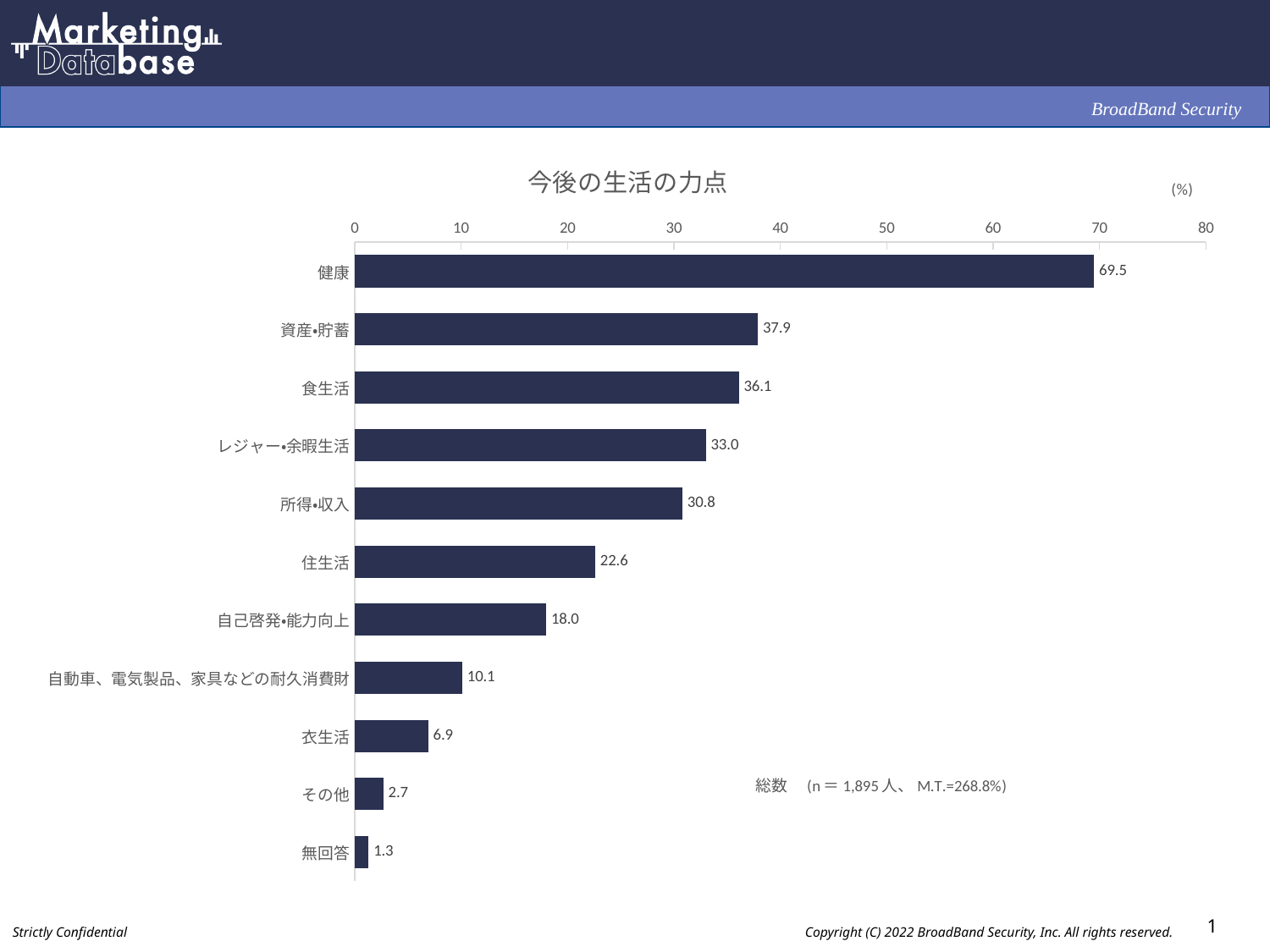
Is the value for 食生活 greater or less than 30? greater What is the value for 自己啓発•能力向上? 18.0 What is the difference between the values for 健康 and 資産•貯蓄? 31.6 Which category has the lowest value? 無回答 What is the value for 健康? 69.5 What kind of chart is shown on the slide? bar chart Which is larger, the value for 住生活 or the value for 所得•収入? 所得•収入 How many categories are shown in the chart? 11 Which category has the highest value? 健康 What is the title of the chart? 今後の生活の力点 What is the sample size (n) shown on the chart? 1,895 人 What is the value for 資産•貯蓄? 37.9